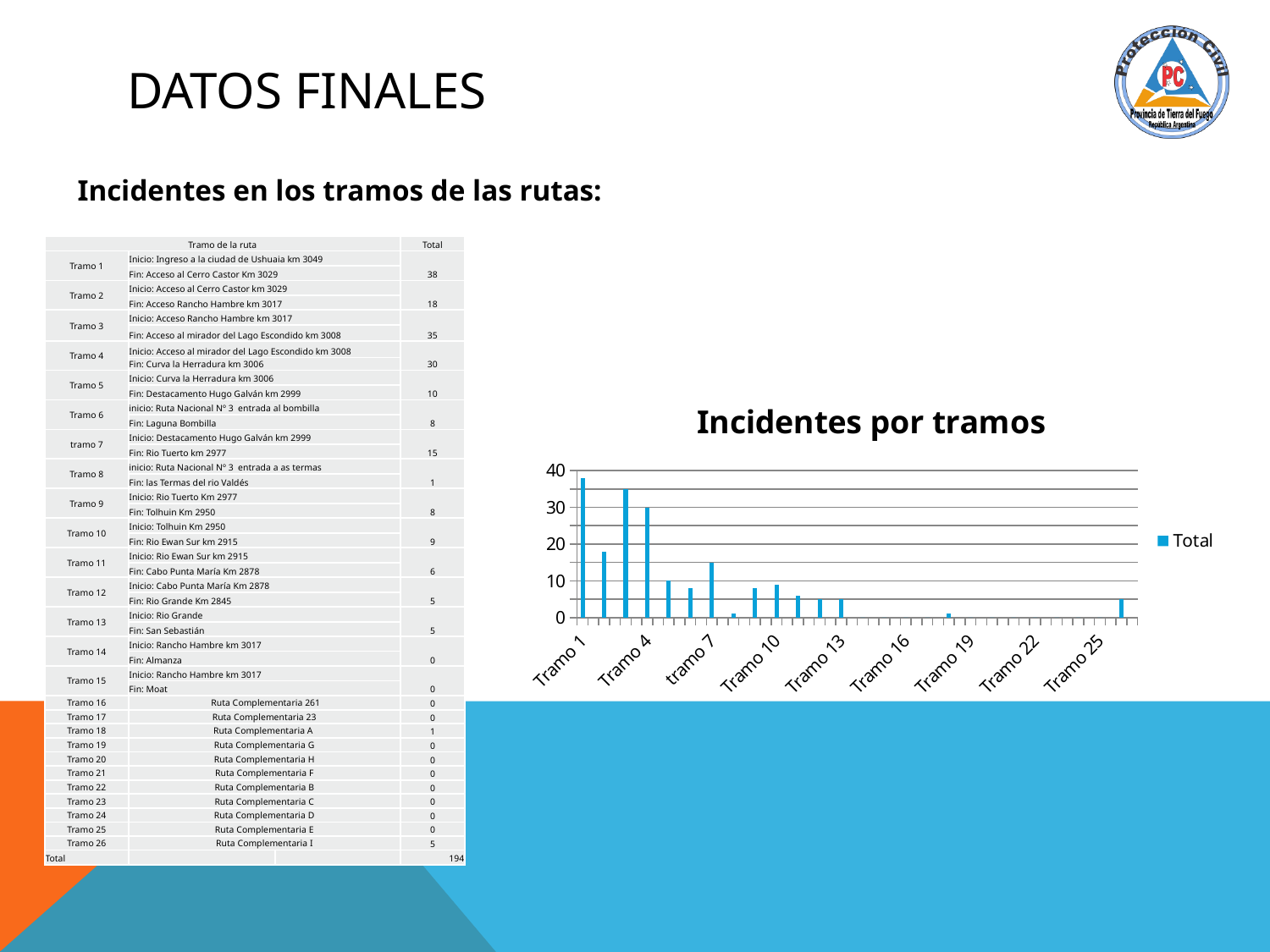
What kind of chart is 'Incidentes por tramos'? bar chart According to the table on the slide, what is the total for Tramo 1? 38 In the 'Incidentes por tramos' chart, is the value for Tramo 7 greater or less than 10? greater In the 'Incidentes por tramos' chart, is the value for Tramo 1 greater or less than 30? greater According to the table on the slide, what is the difference between the totals for Tramo 1 and Tramo 2? 20 In the 'Incidentes por tramos' chart, is the value for Tramo 2 greater or less than 20? less In the 'Incidentes por tramos' chart, which is larger, the value for Tramo 3 or the value for Tramo 4? Tramo 3 What is the name of the series shown in the legend of the chart? Total Which tramo has the highest value in the 'Incidentes por tramos' chart? Tramo 1 What is the title of the chart on the slide? Incidentes por tramos In the 'Incidentes por tramos' chart, which is larger, the value for Tramo 10 or the value for Tramo 11? Tramo 10 How many series does the legend of the 'Incidentes por tramos' chart list? 1